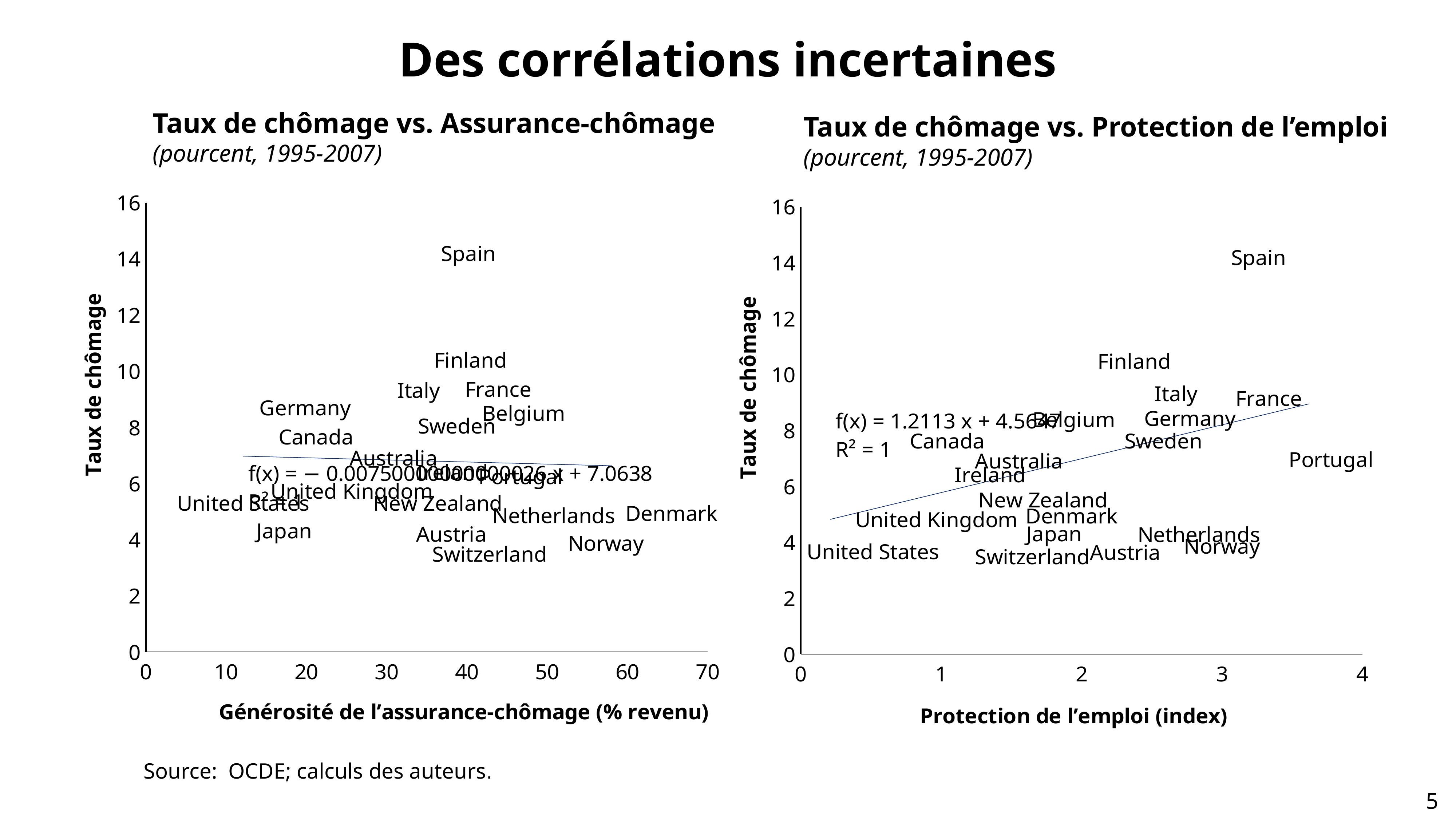
In the right chart 'Taux de chômage vs. Protection de l'emploi', which country has the highest unemployment rate? Spain What is the x-axis label of the right chart 'Taux de chômage vs. Protection de l'emploi'? Protection de l'emploi (index) In the left chart 'Taux de chômage vs. Assurance-chômage', is the unemployment rate for Japan greater or less than 6? less In the left chart 'Taux de chômage vs. Assurance-chômage', which country has the highest unemployment rate? Spain In the right chart 'Taux de chômage vs. Protection de l'emploi', is the unemployment rate for Finland greater or less than 8? greater What is the y-axis label of the left chart 'Taux de chômage vs. Assurance-chômage'? Taux de chômage In the left chart 'Taux de chômage vs. Assurance-chômage', is the unemployment rate for Spain greater or less than 12? greater In the right chart 'Taux de chômage vs. Protection de l'emploi', which has the higher unemployment rate, Spain or Portugal? Spain In the right chart 'Taux de chômage vs. Protection de l'emploi', does the fitted trend line rise or fall as the employment protection index increases? rises What kind of chart is the left chart, 'Taux de chômage vs. Assurance-chômage'? scatter chart